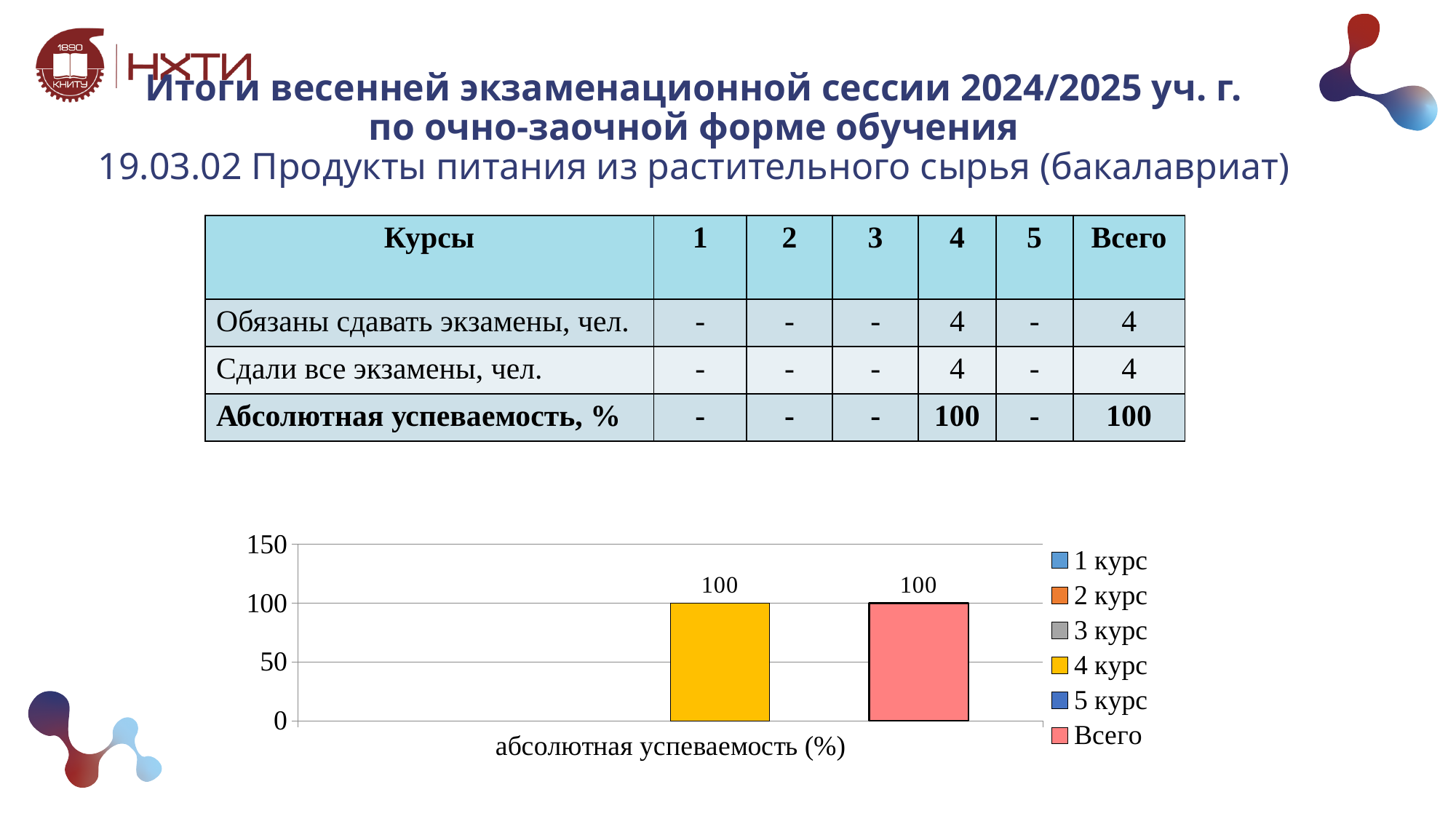
What is the value of the bar for "Всего" in the chart? 100 What is the difference between the values for "4 курс" and "Всего" in the chart? 0 What is the value of the bar for "4 курс" in the chart? 100 What colour is the bar for "4 курс" in the chart? yellow What kind of chart is shown on the slide? bar chart What is the category label shown on the x axis of the chart? абсолютная успеваемость (%) Is the value for "4 курс" greater or less than 50? greater How many bars are visibly plotted in the chart? 2 How many series does the chart legend list? 6 What is the highest value shown on the y axis of the chart? 150 Is the value for "Всего" greater or less than 150? less